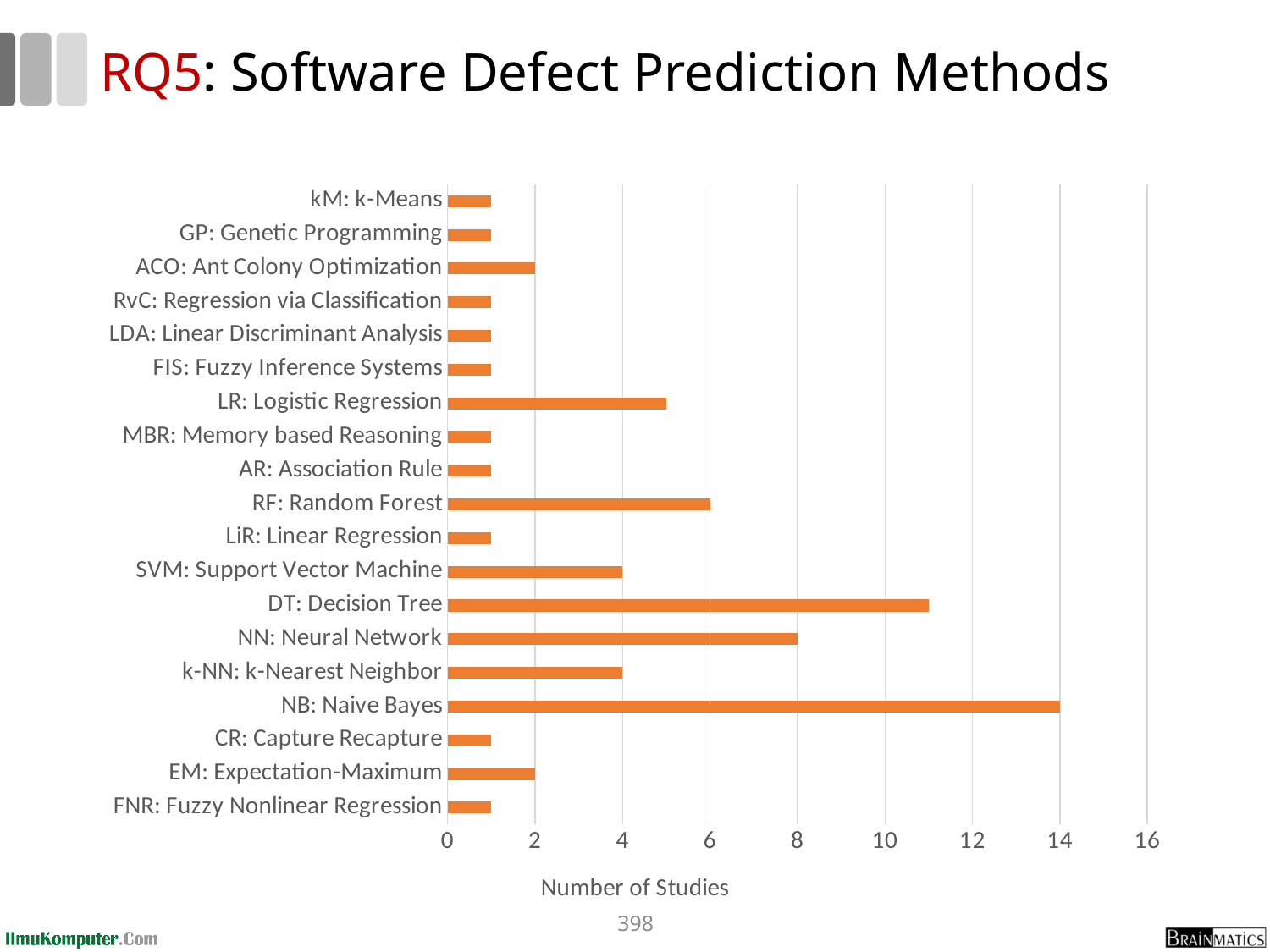
How many studies are shown for NN: Neural Network? 8 What is the difference in number of studies between NB: Naive Bayes and NN: Neural Network? 6 What is the label of the horizontal axis? Number of Studies Which method has the highest number of studies? NB: Naive Bayes How many methods are listed on the chart? 19 What kind of chart is shown on the slide? bar chart How many studies are shown for NB: Naive Bayes? 14 How many studies are shown for RF: Random Forest? 6 Which has more studies, DT: Decision Tree or NN: Neural Network? DT: Decision Tree Is the value for LR: Logistic Regression greater or less than 4? greater Is the value for DT: Decision Tree greater or less than 10? greater How many studies are shown for SVM: Support Vector Machine? 4